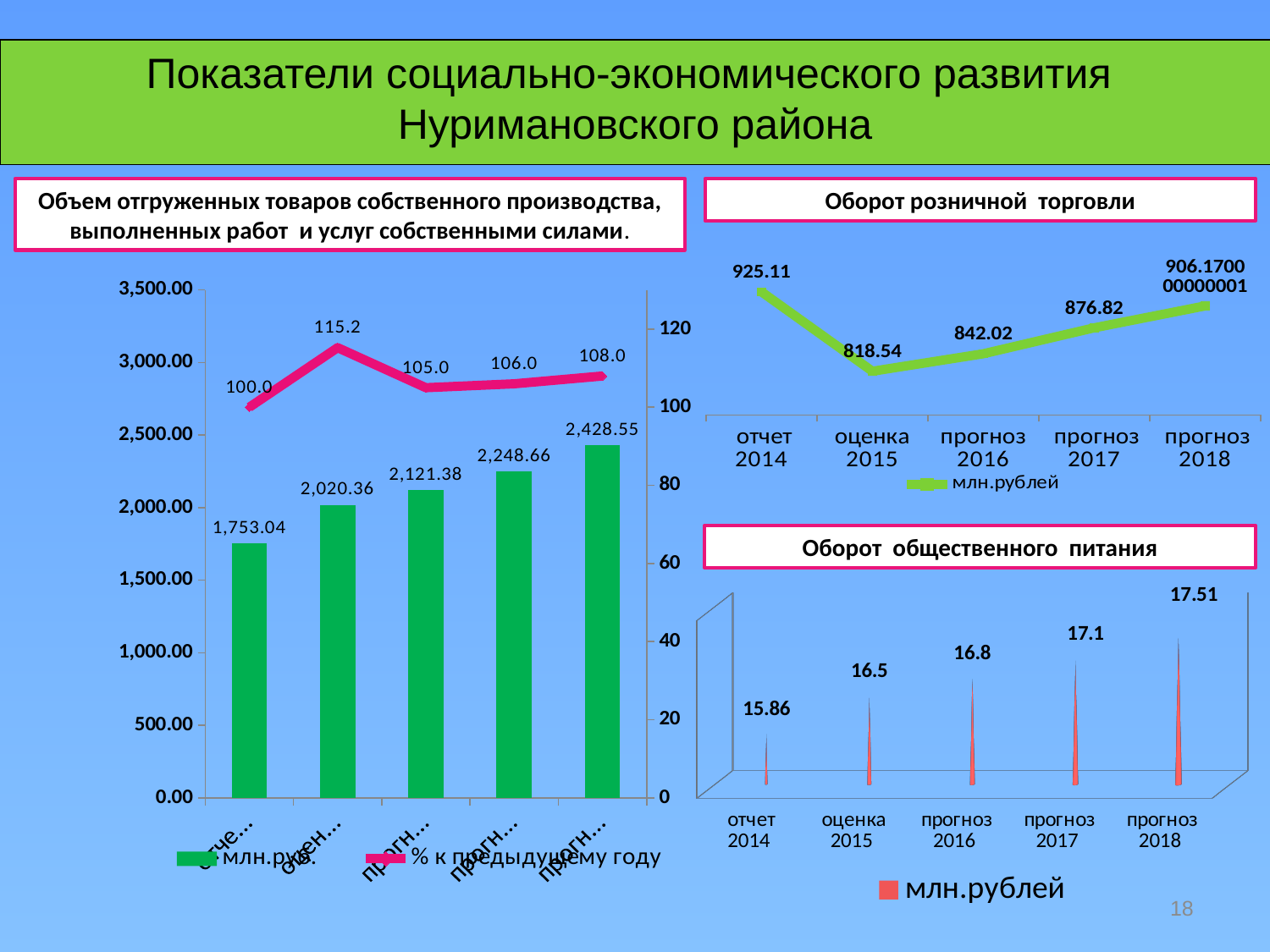
On the left chart 'Объем отгруженных товаров собственного производства', what is the highest value of the '% к предыдущему году' line? 115.2 On the 'Оборот общественного питания' chart, do the values rise or fall from отчет 2014 to прогноз 2018? rise On the left chart 'Объем отгруженных товаров собственного производства', what is the value of the first (leftmost) bar? 1,753.04 On the 'Оборот общественного питания' chart, what is the difference between the values for прогноз 2017 and оценка 2015? 0.6 How many series does the legend of the left chart 'Объем отгруженных товаров собственного производства' list? 2 On the 'Оборот розничной торговли' chart, what is the value for отчет 2014? 925.11 On the 'Оборот розничной торговли' chart, how many data points are plotted? 5 On the 'Оборот розничной торговли' chart, what is the difference between the values for отчет 2014 and оценка 2015? 106.57 On the left chart 'Объем отгруженных товаров собственного производства', what is the value of the tallest bar? 2,428.55 On the 'Оборот общественного питания' chart, which category has the lowest value? отчет 2014 On the 'Оборот общественного питания' chart, what is the value for прогноз 2018? 17.51 On the 'Оборот розничной торговли' chart, which category has the lowest value? оценка 2015